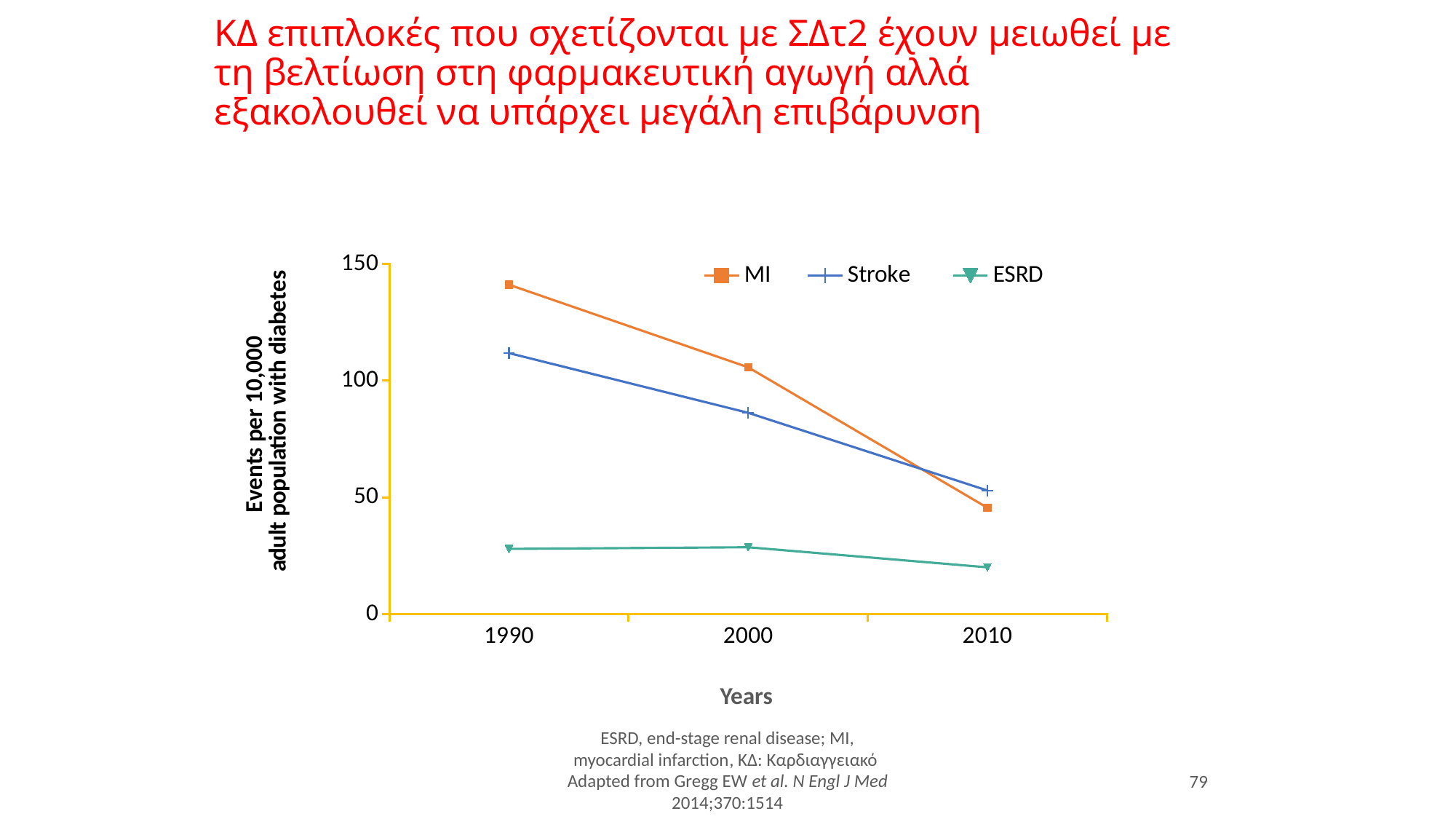
What is the title of the y axis? Events per 10,000 adult population with diabetes Do the values for Stroke rise or fall from 1990 to 2010? fall Which series does the legend list first? MI Do the values for MI rise or fall from 1990 to 2010? fall Is the value for MI in 1990 greater or less than 100? greater How many series does the legend list? 3 How many years are shown on the x axis? 3 Which series has the lowest value in 2010? ESRD What kind of chart is shown on the slide? line chart Which series has the highest value in 1990? MI Is the value for ESRD in 2000 greater or less than 50? less